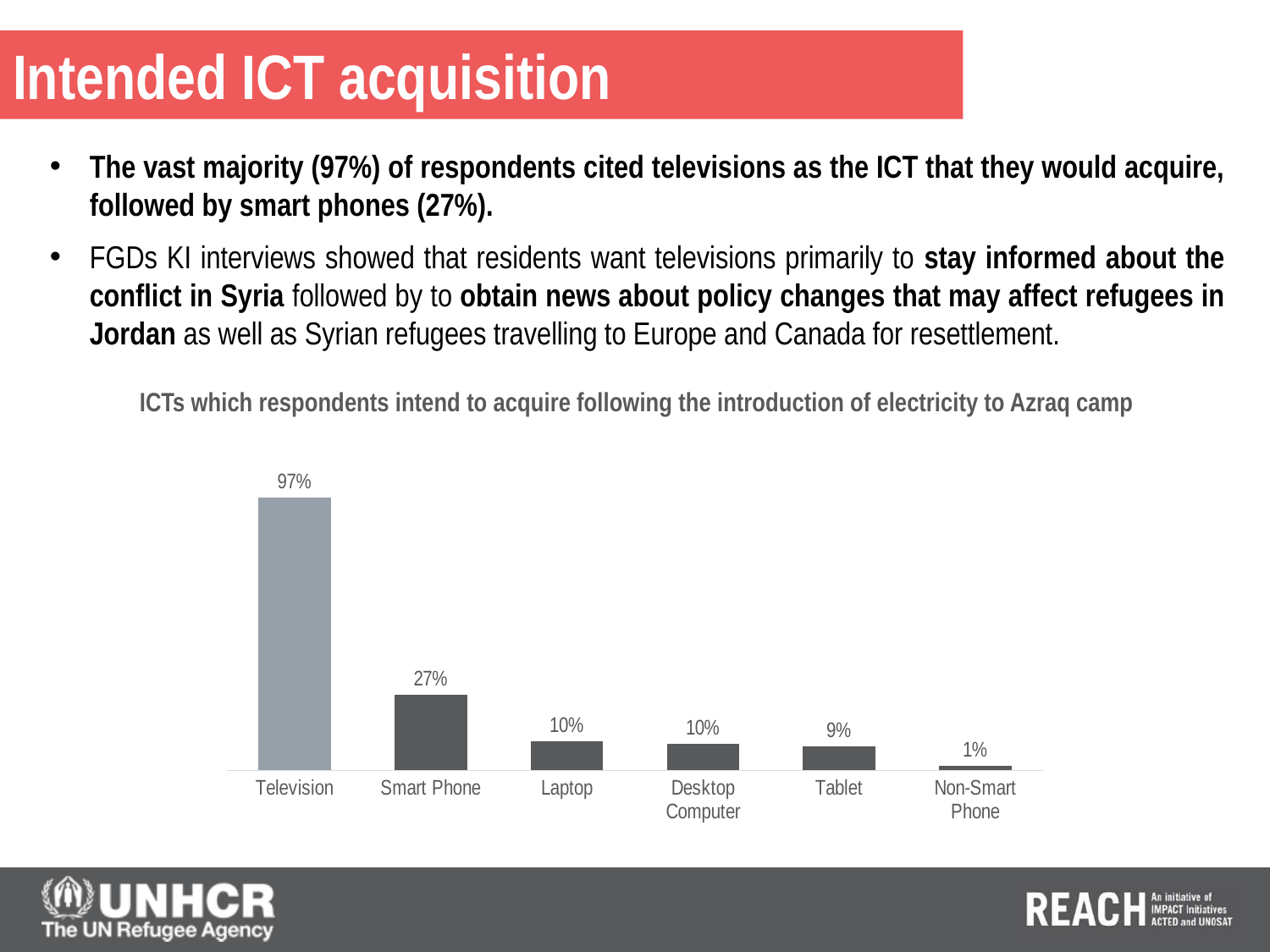
Which has a higher value, Smart Phone or Laptop? Smart Phone What is the title of the chart? ICTs which respondents intend to acquire following the introduction of electricity to Azraq camp How many ICT categories are shown in the chart? 6 What is the difference in percentage points between Television and Smart Phone? 70 What percentage of respondents intend to acquire a tablet? 9% What percentage of respondents intend to acquire a television? 97% Which ICT has the lowest percentage of respondents intending to acquire it? Non-Smart Phone What type of chart is shown on the slide? Bar chart What is the value shown for Non-Smart Phone? 1% What is the difference in percentage points between Tablet and Non-Smart Phone? 8 What is the value shown for Smart Phone? 27% Which ICT has the highest percentage of respondents intending to acquire it? Television